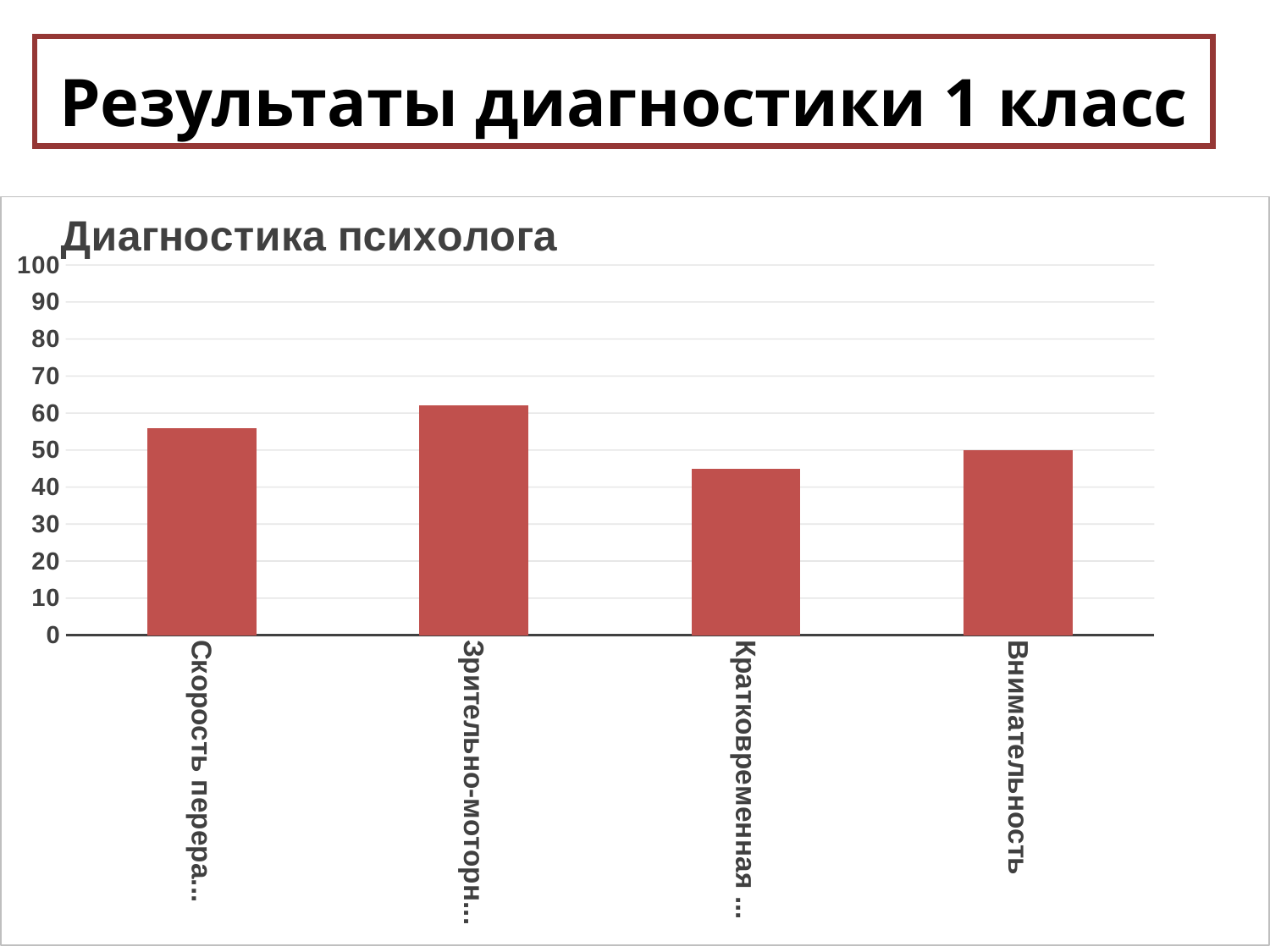
Which is larger: the value for "Скорость перера..." (first bar) or the value for "Внимательность" (fourth bar)? Скорость перера... Which category has the highest bar in the "Диагностика психолога" chart? Зрительно-моторн... (the second bar) Which is larger: the value for "Зрительно-моторн..." (second bar) or the value for "Кратковременная ..." (third bar)? Зрительно-моторн... Is the value for "Зрительно-моторн..." (the second bar) greater or less than 70? less Is the value for "Скорость перера..." (the first bar) greater or less than 50? greater What is the title of the chart on the slide? Диагностика психолога How many categories (bars) are plotted in the "Диагностика психолога" chart? 4 Is the value for "Внимательность" greater or less than 70? less What kind of chart is shown under the title "Диагностика психолога"? bar chart Which category has the lowest bar in the "Диагностика психолога" chart? Кратковременная ... (the third bar) What is the title of the slide? Результаты диагностики 1 класс